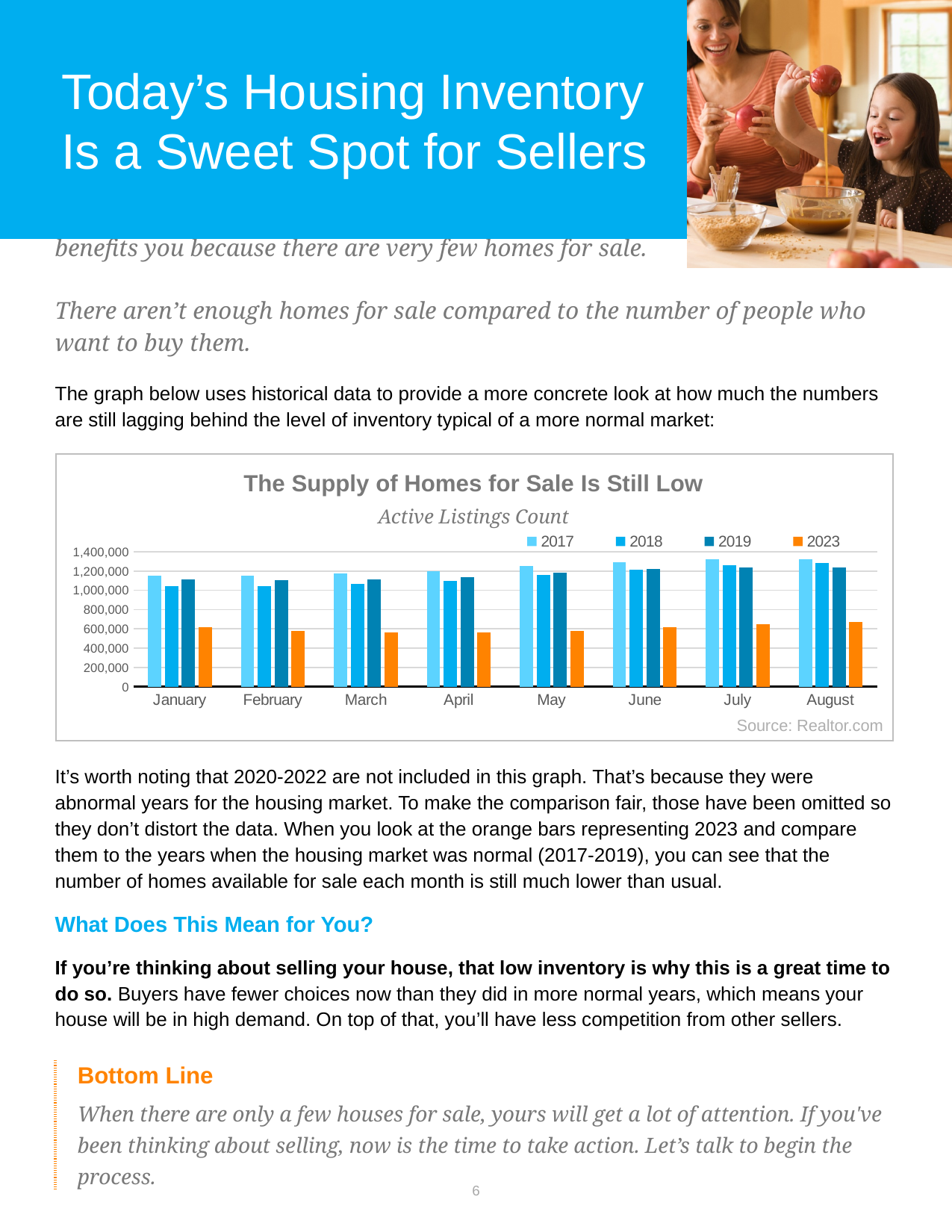
How many months are shown on the x axis of the chart? 8 Do the 2023 values rise or fall from May to August? rise How many series does the chart legend list? 4 In January, which series has the larger value, 2017 or 2023? 2017 What kind of chart is shown on the slide? bar chart Is the value for 2017 in July greater or less than 1,200,000? greater What is the title of the chart? The Supply of Homes for Sale Is Still Low Which series has the lowest value in every month shown? 2023 Is the value for 2023 in January greater or less than 800,000? less What source is cited for the chart data? Realtor.com Is the value for 2023 in August greater or less than 400,000? greater